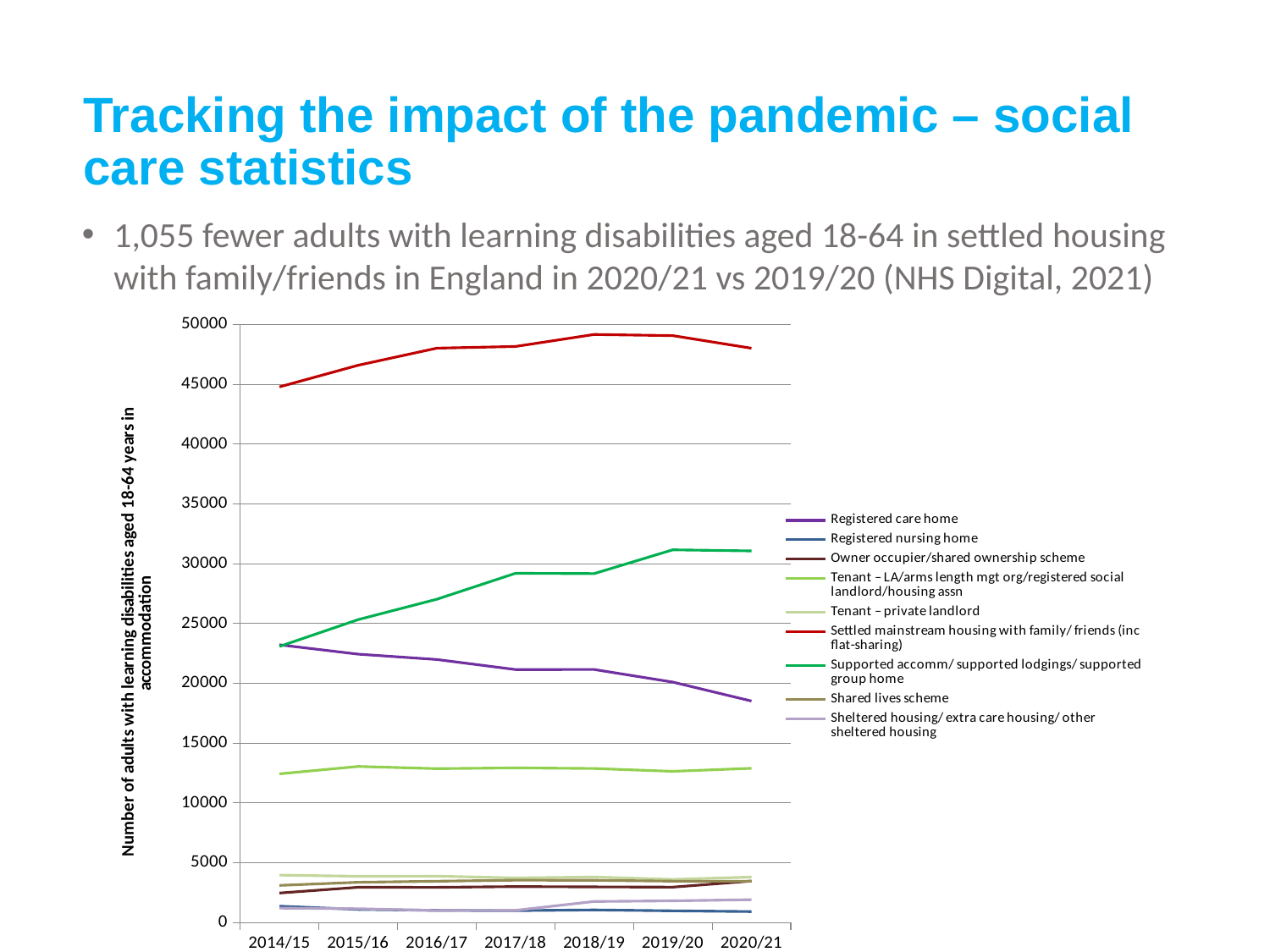
Is the value for Registered care home in 2020/21 greater or less than 20000? less Does the Supported accomm/ supported lodgings/ supported group home series rise or fall from 2014/15 to 2020/21? Rise Is the value for Supported accomm/ supported lodgings/ supported group home in 2020/21 greater or less than 30000? greater Which series has the lowest value in 2020/21? Registered nursing home How many series does the chart's legend list? 9 Which series has the highest values across all years in the chart? Settled mainstream housing with family/ friends (inc flat-sharing) What kind of chart is shown on the slide? Line chart What is the title of the chart's vertical axis? Number of adults with learning disabilities aged 18-64 years in accommodation In 2020/21, which is larger: Supported accomm/ supported lodgings/ supported group home or Registered care home? Supported accomm/ supported lodgings/ supported group home How many years are shown along the x axis of the chart? 7 Is the value for Settled mainstream housing with family/ friends in 2020/21 greater or less than 45000? greater